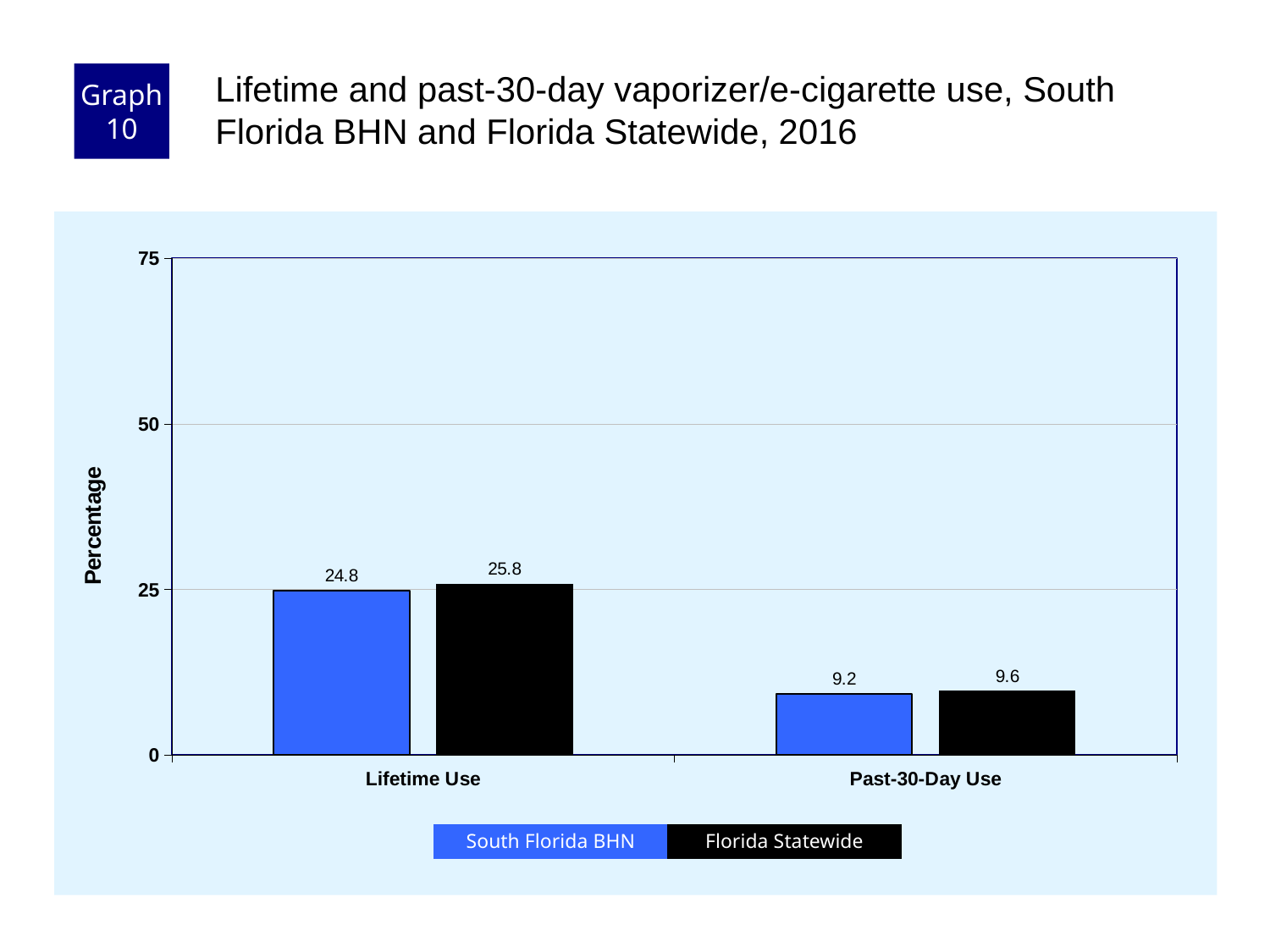
What is the difference between the Florida Statewide and South Florida BHN values for Lifetime Use? 1.0 Which category has the highest value for Florida Statewide? Lifetime Use What is the value for South Florida BHN for Lifetime Use? 24.8 How many series does the legend list? 2 How many categories are shown on the x axis? 2 What kind of chart is shown on the slide? Bar chart What is the value for South Florida BHN for Past-30-Day Use? 9.2 What is the value for Florida Statewide for Past-30-Day Use? 9.6 Which category has the lowest value for South Florida BHN? Past-30-Day Use Which is larger: the South Florida BHN value for Lifetime Use or the South Florida BHN value for Past-30-Day Use? Lifetime Use What is the difference between the Florida Statewide and South Florida BHN values for Past-30-Day Use? 0.4 What is the value for Florida Statewide for Lifetime Use? 25.8